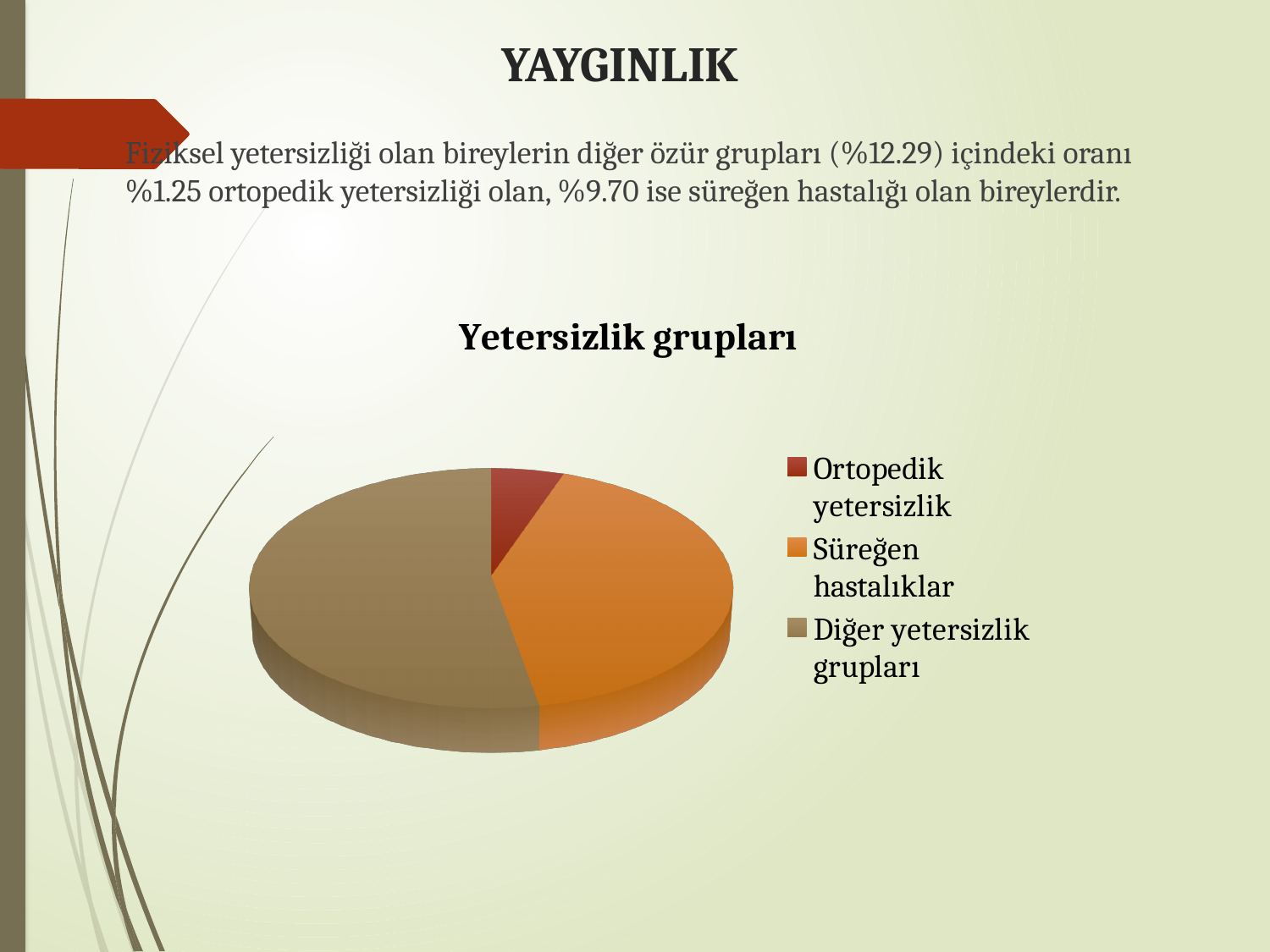
Which category has the largest slice of the pie? Diğer yetersizlik grupları Which category has the smallest slice of the pie? Ortopedik yetersizlik Which legend entry is shown in orange? Süreğen hastalıklar What is the title of the chart? Yetersizlik grupları What kind of chart is shown on the slide? Pie chart How many slices does the pie chart have? 3 Which slice is larger: Süreğen hastalıklar or Ortopedik yetersizlik? Süreğen hastalıklar Which slice is larger: Diğer yetersizlik grupları or Süreğen hastalıklar? Diğer yetersizlik grupları How many entries does the chart legend list? 3